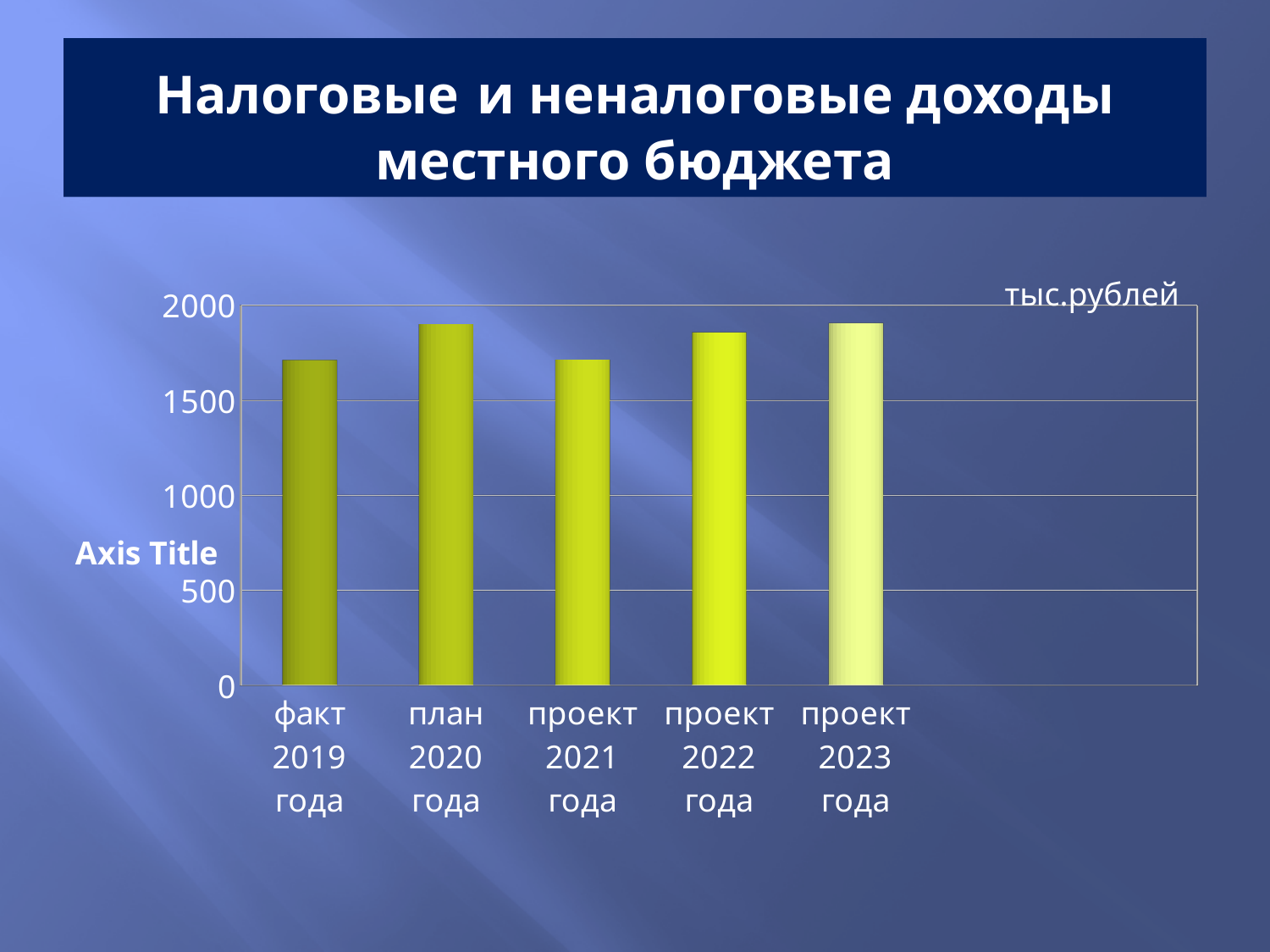
What kind of chart is shown on the slide? bar chart Which is larger, the value for план 2020 года or the value for проект 2021 года? план 2020 года Which is larger, the value for факт 2019 года or the value for проект 2022 года? проект 2022 года What is the title of the slide above the chart? Налоговые и неналоговые доходы местного бюджета Is the value for факт 2019 года greater or less than 1500? greater Which is larger, the value for проект 2021 года or the value for проект 2023 года? проект 2023 года How many bars (categories) does the chart show? 5 Is the value for проект 2023 года greater or less than 1500? greater Is the value for проект 2022 года greater or less than 2000? less What unit is indicated in the top-right corner of the chart? тыс.рублей